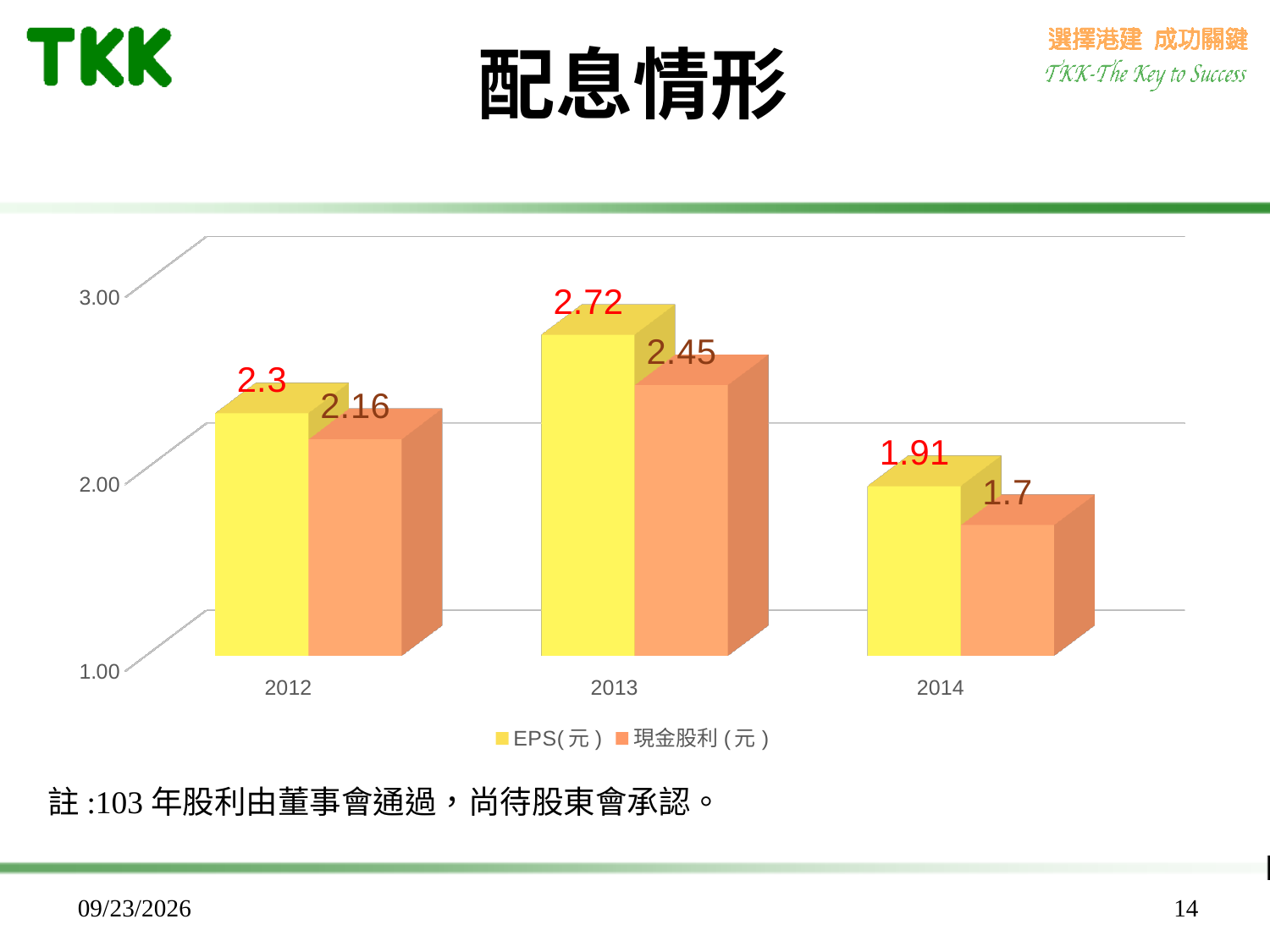
What kind of chart is shown on the slide? Bar chart Which is larger, the EPS(元) for 2012 or the 現金股利(元) for 2013? 現金股利(元) for 2013 What is the difference between EPS(元) and 現金股利(元) in 2013? 0.27 How many series does the legend list? 2 What is the EPS(元) value for 2013? 2.72 What is the 現金股利(元) value for 2014? 1.7 Which year has the highest EPS(元)? 2013 How many years are shown on the x axis? 3 Which year has the lowest 現金股利(元)? 2014 What is the 現金股利(元) value for 2012? 2.16 Is the EPS(元) value for 2014 greater or less than 2.00? less What is the difference between the EPS(元) for 2012 and 2014? 0.39